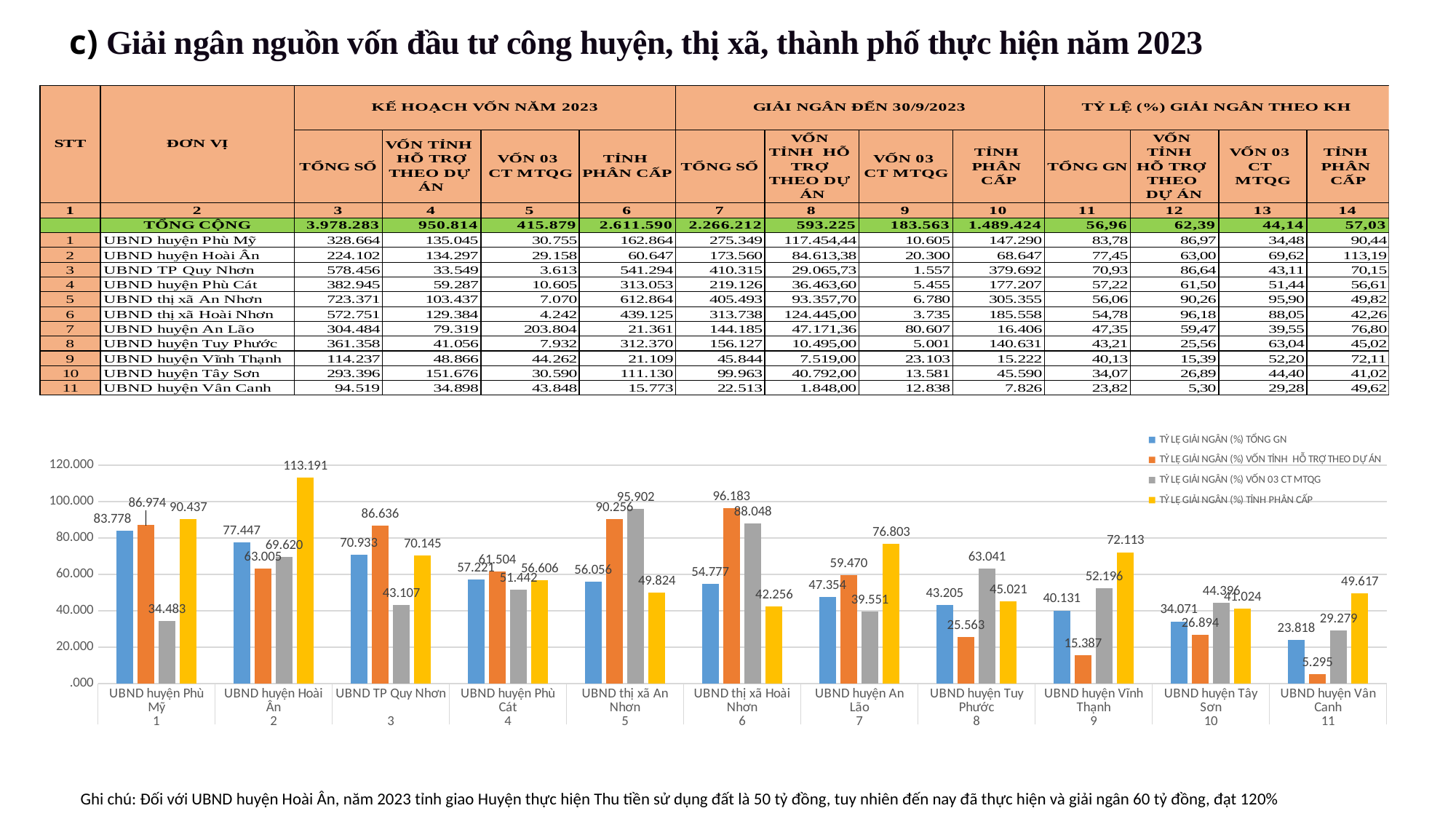
How many series does the chart legend list? 4 Does the TỶ LỆ GIẢI NGÂN (%) TỔNG GN series rise or fall from left to right across the x axis? fall What colour are the bars for the TỶ LỆ GIẢI NGÂN (%) TỈNH PHÂN CẤP series? yellow Which category has the highest value in the TỶ LỆ GIẢI NGÂN (%) TỔNG GN series? UBND huyện Phù Mỹ What type of chart is shown on the slide? bar chart Which is larger: the TỶ LỆ GIẢI NGÂN (%) VỐN 03 CT MTQG value for UBND huyện Tuy Phước or for UBND huyện Tây Sơn? UBND huyện Tuy Phước Which category has the lowest value in the TỶ LỆ GIẢI NGÂN (%) VỐN TỈNH HỖ TRỢ THEO DỰ ÁN series? UBND huyện Vân Canh In the chart, what is the value of the TỶ LỆ GIẢI NGÂN (%) VỐN 03 CT MTQG series for UBND thị xã An Nhơn? 95.902 In the chart, what is the value of the TỶ LỆ GIẢI NGÂN (%) TỔNG GN series for UBND huyện Phù Mỹ? 83.778 In the chart, what is the value of the TỶ LỆ GIẢI NGÂN (%) TỈNH PHÂN CẤP series for UBND huyện Hoài Ân? 113.191 How many categories (units) are shown on the x axis of the chart? 11 What is the difference between the TỶ LỆ GIẢI NGÂN (%) TỔNG GN values for UBND huyện Phù Mỹ and UBND huyện Vân Canh? 59.960